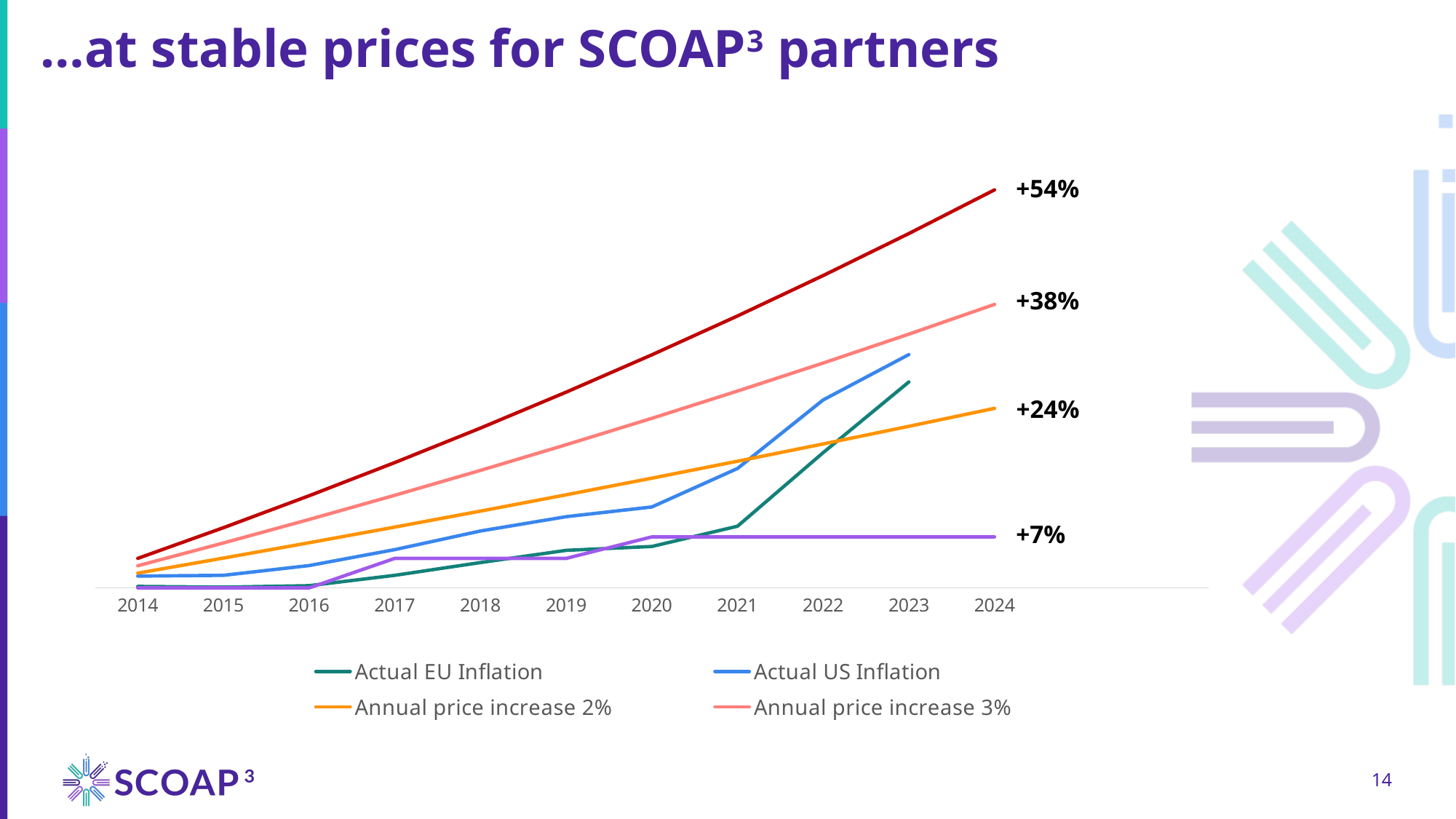
What value label is shown at the 2024 end of the Annual price increase 3% line? +38% In 2023, which is higher: Actual US Inflation or Actual EU Inflation? Actual US Inflation How many years are shown on the x axis of the chart? 11 How many series does the chart legend list? 4 Does the Annual price increase 2% line rise or fall from 2014 to 2024? Rises What is the difference between the 2024 labels of the Annual price increase 3% line and the Annual price increase 2% line? 14 percentage points What is the highest end-of-line value label shown on the chart? +54% What kind of chart is shown on the slide? Line chart What is the lowest end-of-line value label shown on the chart? +7% In 2022, is the Actual US Inflation line above or below the Annual price increase 2% line? Above What value label is shown at the 2024 end of the Annual price increase 2% line? +24% What is the title of the slide containing the chart? …at stable prices for SCOAP³ partners